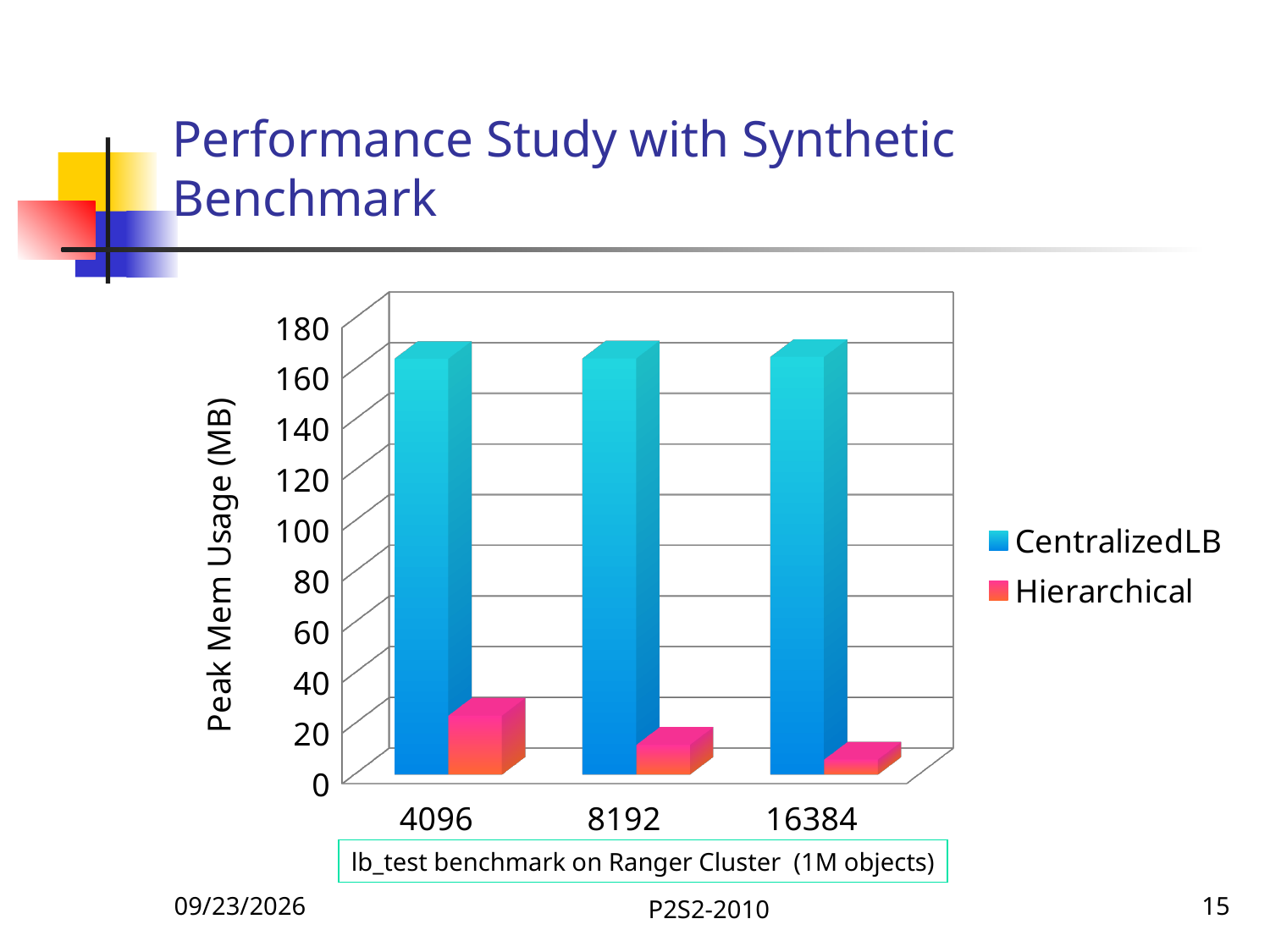
Is the Hierarchical value for 4096 greater or less than 40? less Is the CentralizedLB value for 4096 greater or less than 140? greater What is the label of the y axis? Peak Mem Usage (MB) How many series does the legend list? 2 For the Hierarchical series, which category has the highest value? 4096 What kind of chart is shown on the slide? bar chart How many categories are shown on the x axis? 3 For the Hierarchical series, which category has the lowest value? 16384 Is the Hierarchical value for 16384 greater or less than 20? less At 8192, which series has the larger value, CentralizedLB or Hierarchical? CentralizedLB Which series is shown in pink/red? Hierarchical